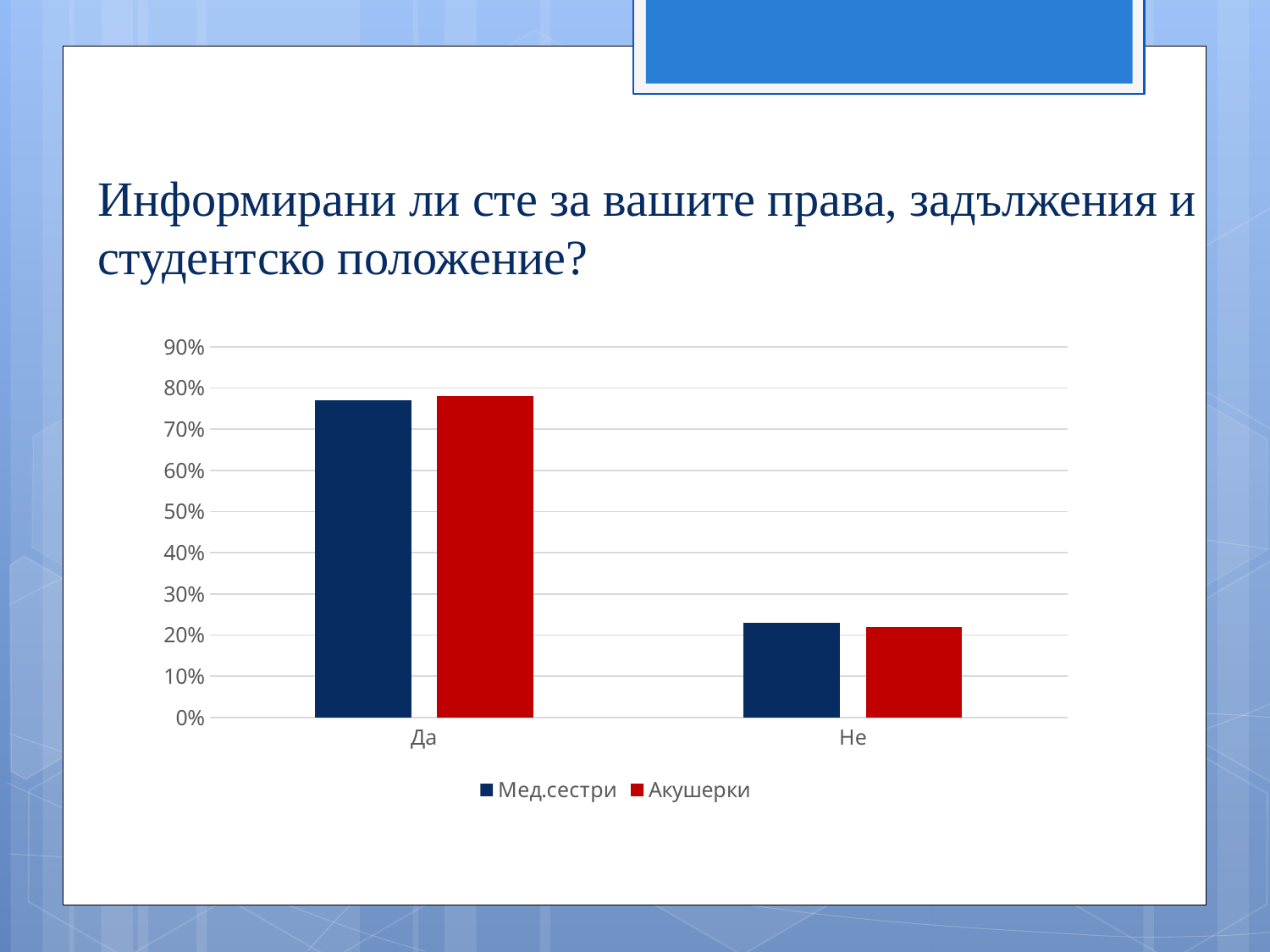
How many series does the chart's legend list? 2 For Мед.сестри, which category has the larger value, Да or Не? Да Is the value for Акушерки in the Да category greater or less than 80%? less Is the value for Акушерки in the Не category greater or less than 20%? greater Is the value for Мед.сестри in the Не category greater or less than 30%? less What is the highest value shown on the chart's vertical axis? 90% How many categories are shown on the x axis of the chart? 2 Which series is shown in red in the chart? Акушерки For Акушерки, which category has the smaller value, Да or Не? Не What kind of chart is shown on the slide? bar chart Do the values for Акушерки rise or fall from Да to Не? fall